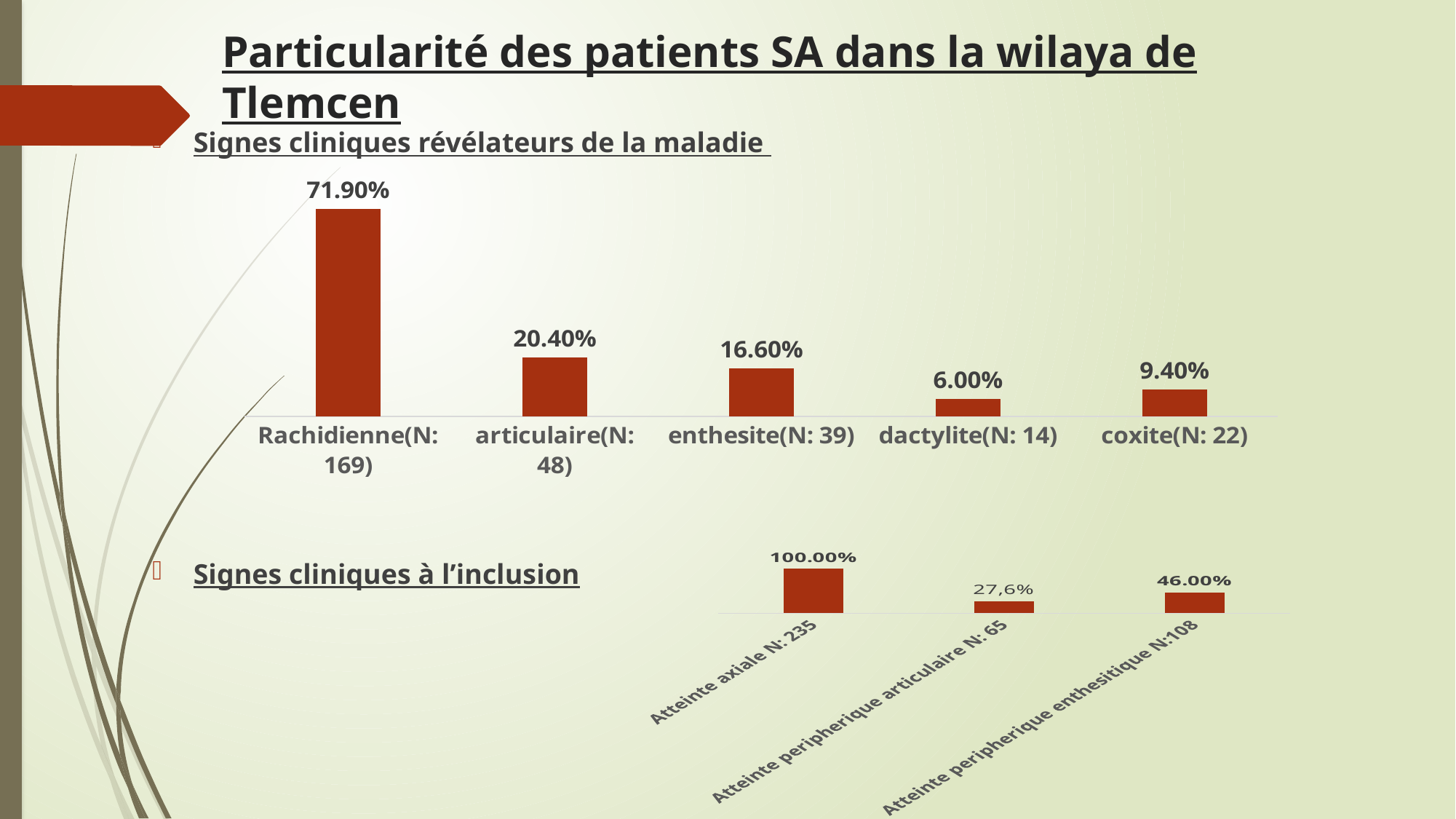
In the lower chart (Signes cliniques à l'inclusion), what is the value for Atteinte peripherique articulaire N: 65? 27,6% In the lower chart (Signes cliniques à l'inclusion), what is the value for Atteinte peripherique enthesitique N:108? 46.00% How many categories are shown in the lower chart (Signes cliniques à l'inclusion)? 3 What kind of chart is the lower chart (Signes cliniques à l'inclusion)? bar chart In the lower chart (Signes cliniques à l'inclusion), which category has the highest value? Atteinte axiale N: 235 In the upper chart (Signes cliniques révélateurs de la maladie), which is larger: the value for enthesite(N: 39) or coxite(N: 22)? enthesite(N: 39) In the upper chart (Signes cliniques révélateurs de la maladie), which category has the lowest value? dactylite(N: 14) How many categories are shown in the upper chart (Signes cliniques révélateurs de la maladie)? 5 In the upper chart (Signes cliniques révélateurs de la maladie), what is the value for enthesite(N: 39)? 16.60% In the upper chart (Signes cliniques révélateurs de la maladie), what is the difference between the values for articulaire(N: 48) and coxite(N: 22)? 11.00% In the upper chart (Signes cliniques révélateurs de la maladie), which category has the highest value? Rachidienne(N: 169) In the upper chart (Signes cliniques révélateurs de la maladie), what is the value for Rachidienne(N: 169)? 71.90%